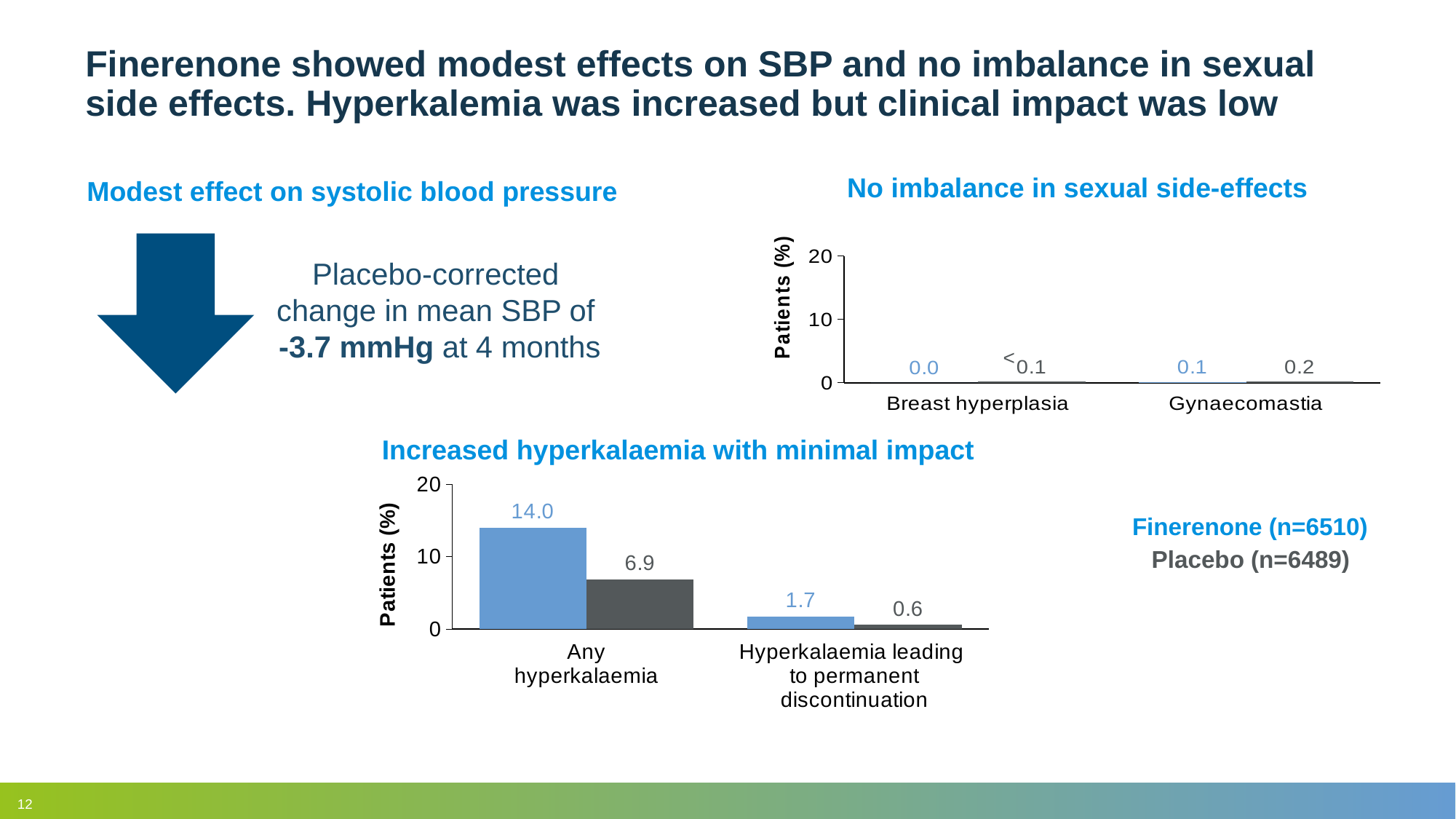
In the 'Increased hyperkalaemia with minimal impact' chart, which is larger for Hyperkalaemia leading to permanent discontinuation, Finerenone or Placebo? Finerenone In the 'Increased hyperkalaemia with minimal impact' chart, what is the difference between the Finerenone and Placebo values for Any hyperkalaemia? 7.1 In the 'Increased hyperkalaemia with minimal impact' chart, what is the value for Placebo for Any hyperkalaemia? 6.9 In the 'Increased hyperkalaemia with minimal impact' chart, is the Finerenone value for Any hyperkalaemia greater or less than 10? greater In the 'Increased hyperkalaemia with minimal impact' chart, what is the value for Finerenone for Any hyperkalaemia? 14.0 What kind of chart is the 'Increased hyperkalaemia with minimal impact' chart? bar chart In the 'No imbalance in sexual side-effects' chart, what is the value for Placebo for Gynaecomastia? 0.2 In the 'No imbalance in sexual side-effects' chart, what is the value for Finerenone for Breast hyperplasia? 0.0 In the 'Increased hyperkalaemia with minimal impact' chart, what is the value for Finerenone for Hyperkalaemia leading to permanent discontinuation? 1.7 How many series are shown in the 'Increased hyperkalaemia with minimal impact' chart? 2 In the 'No imbalance in sexual side-effects' chart, what is the value for Placebo for Breast hyperplasia? <0.1 In the 'Increased hyperkalaemia with minimal impact' chart, how many categories are shown on the x axis? 2